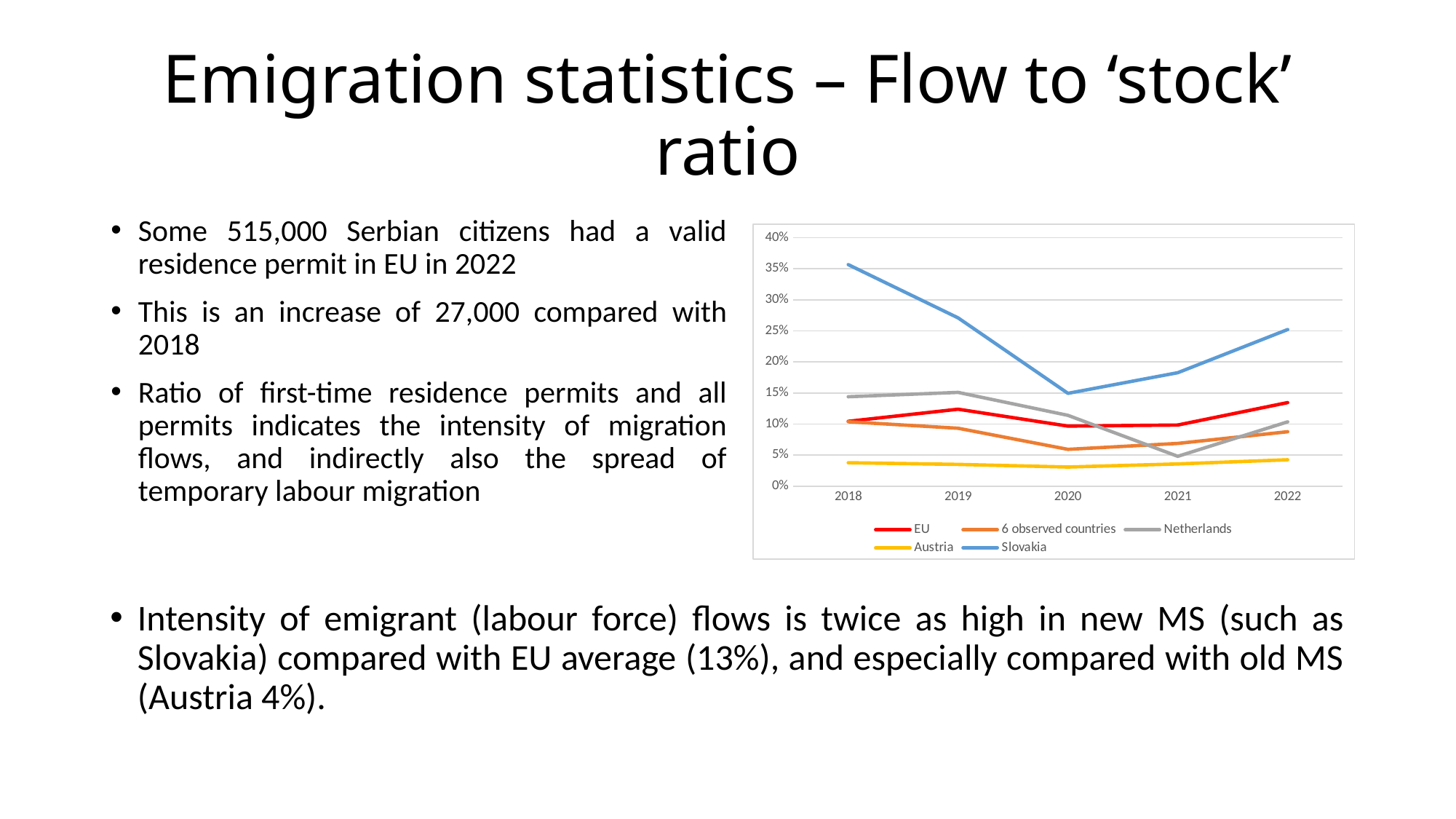
Is the value for Slovakia in 2018 greater or less than 30%? greater Does the Slovakia line rise or fall from 2018 to 2020? fall What kind of chart is shown on the slide? line chart In 2021, which is larger: the value for EU or the value for Netherlands? EU How many series does the chart's legend list? 5 Is the value for Austria in 2022 greater or less than 5%? less Which series has the lowest value in 2022? Austria What colour is the Slovakia line in the chart? blue Is the value for Slovakia in 2020 greater or less than 20%? less In 2019, which is larger: the value for Netherlands or the value for EU? Netherlands How many years are shown on the x axis of the chart? 5 Which series has the highest value in 2018? Slovakia